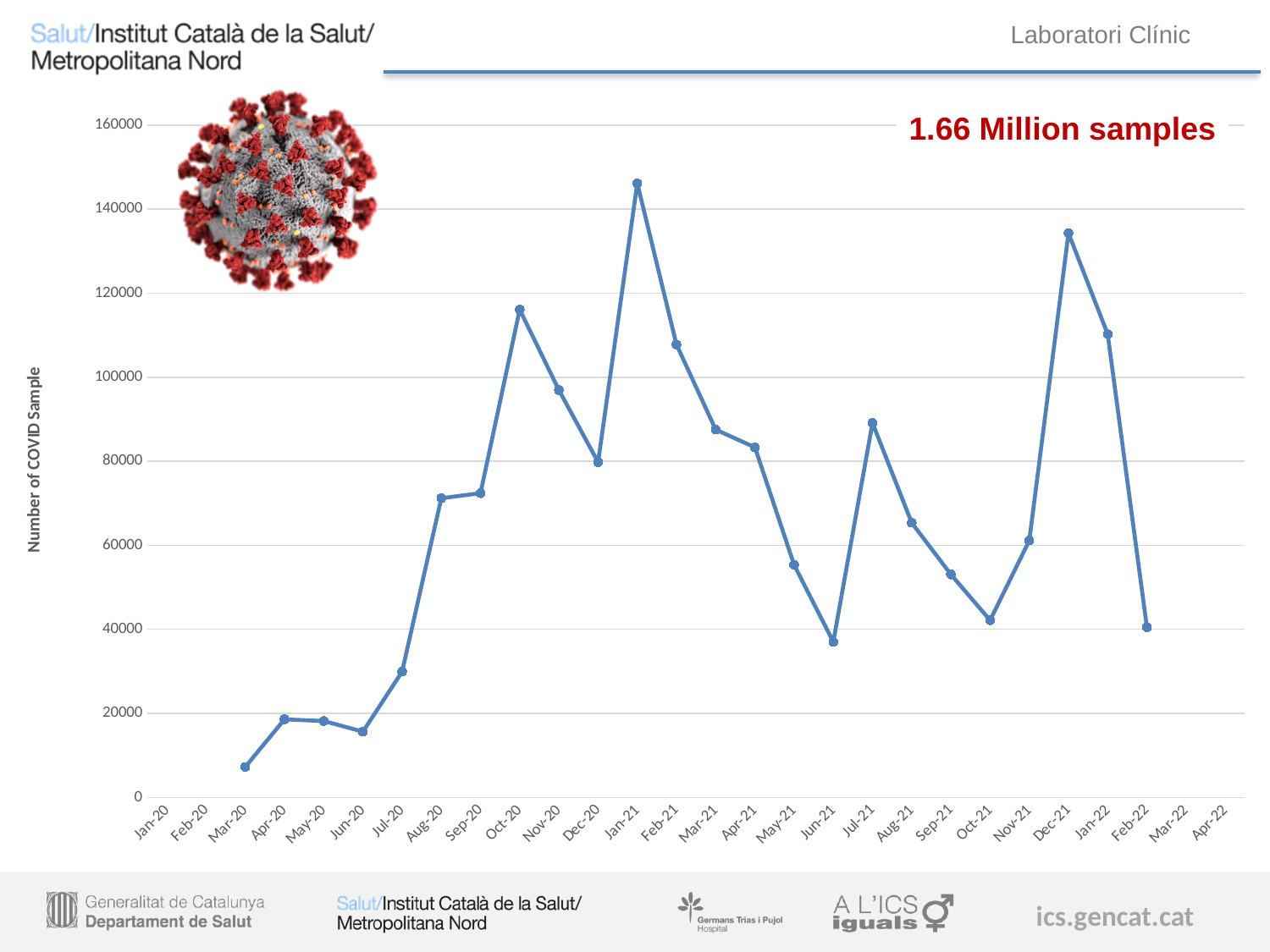
How many data points are plotted on the line? 24 Which is larger, the value for Dec-21 or the value for Jan-22? Dec-21 Is the value for Jul-20 greater or less than 40000? less What is the title of the vertical axis? Number of COVID Sample Which month has the lowest number of COVID samples? Mar-20 Do the values rise or fall from Mar-20 to Oct-20? rise Which month has the highest number of COVID samples? Jan-21 Which is larger, the value for Jan-21 or the value for Feb-21? Jan-21 Is the value for Oct-20 greater or less than 100000? greater What kind of chart is shown on the slide? line chart Is the value for Dec-21 greater or less than 120000? greater